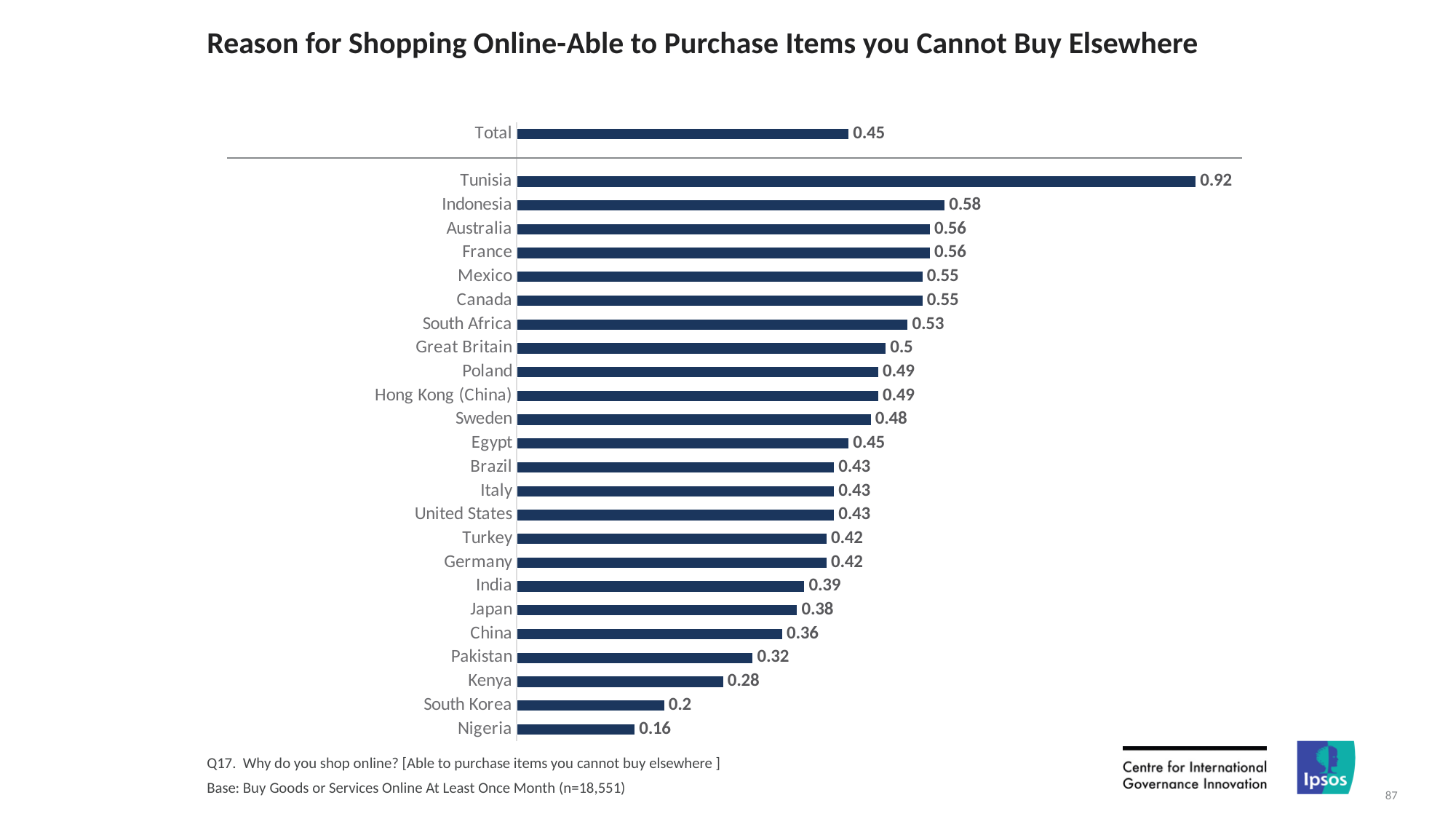
Which country has the highest value? Tunisia How many countries are listed below the Total bar? 23 What is the value for South Korea? 0.2 Which country has the lowest value? Nigeria Which has a larger value, South Africa or Sweden? South Africa What is the value for Great Britain? 0.5 Which has a larger value, Japan or Pakistan? Japan What is the difference between the values for Kenya and Nigeria? 0.12 What is the difference between the values for Tunisia and Indonesia? 0.34 What is the value for Total? 0.45 What kind of chart is shown on the slide? Bar chart What is the value for Tunisia? 0.92